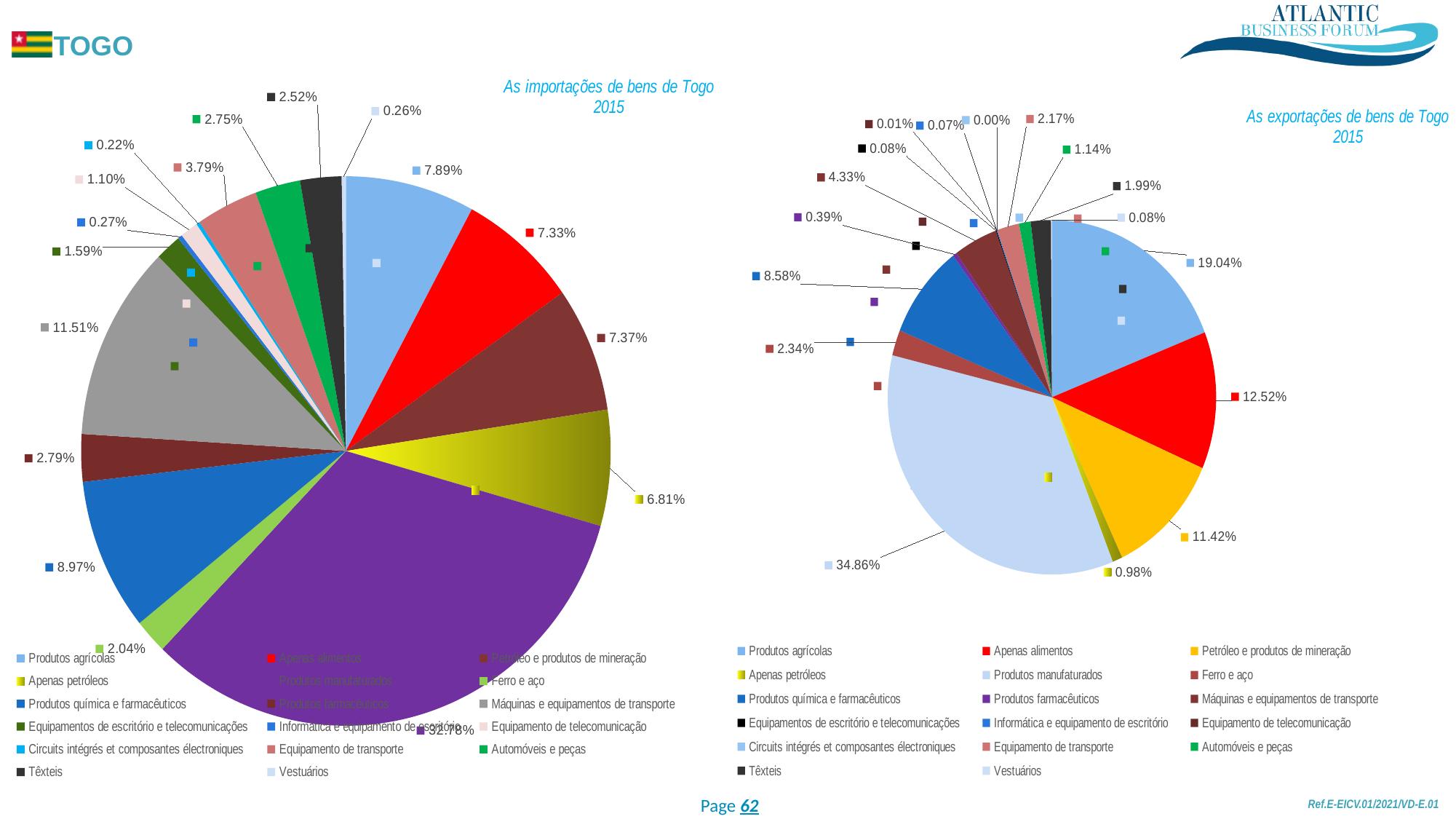
How many entries does the legend of the 'As exportações de bens de Togo 2015' chart list? 17 In the 'As exportações de bens de Togo 2015' chart, what share is shown for Produtos agrícolas? 19.04% In the 'As importações de bens de Togo 2015' chart, what share is shown for Produtos química e farmacêuticos? 8.97% In the 'As exportações de bens de Togo 2015' chart, what share is shown for Apenas alimentos? 12.52% In the 'As importações de bens de Togo 2015' chart, what share is shown for Máquinas e equipamentos de transporte? 11.51% In the 'As exportações de bens de Togo 2015' chart, which is larger: Apenas alimentos or Petróleo e produtos de mineração? Apenas alimentos What type of chart is used for 'As importações de bens de Togo 2015'? pie chart In the 'As importações de bens de Togo 2015' chart, what share is shown for Apenas petróleos? 6.81% In the 'As exportações de bens de Togo 2015' chart, what is the difference between Produtos agrícolas and Apenas alimentos? 6.52% Which category has the largest slice in the 'As importações de bens de Togo 2015' chart? Produtos manufaturados Which category has the largest slice in the 'As exportações de bens de Togo 2015' chart? Produtos manufaturados In the 'As exportações de bens de Togo 2015' chart, what share is shown for Produtos manufaturados? 34.86%